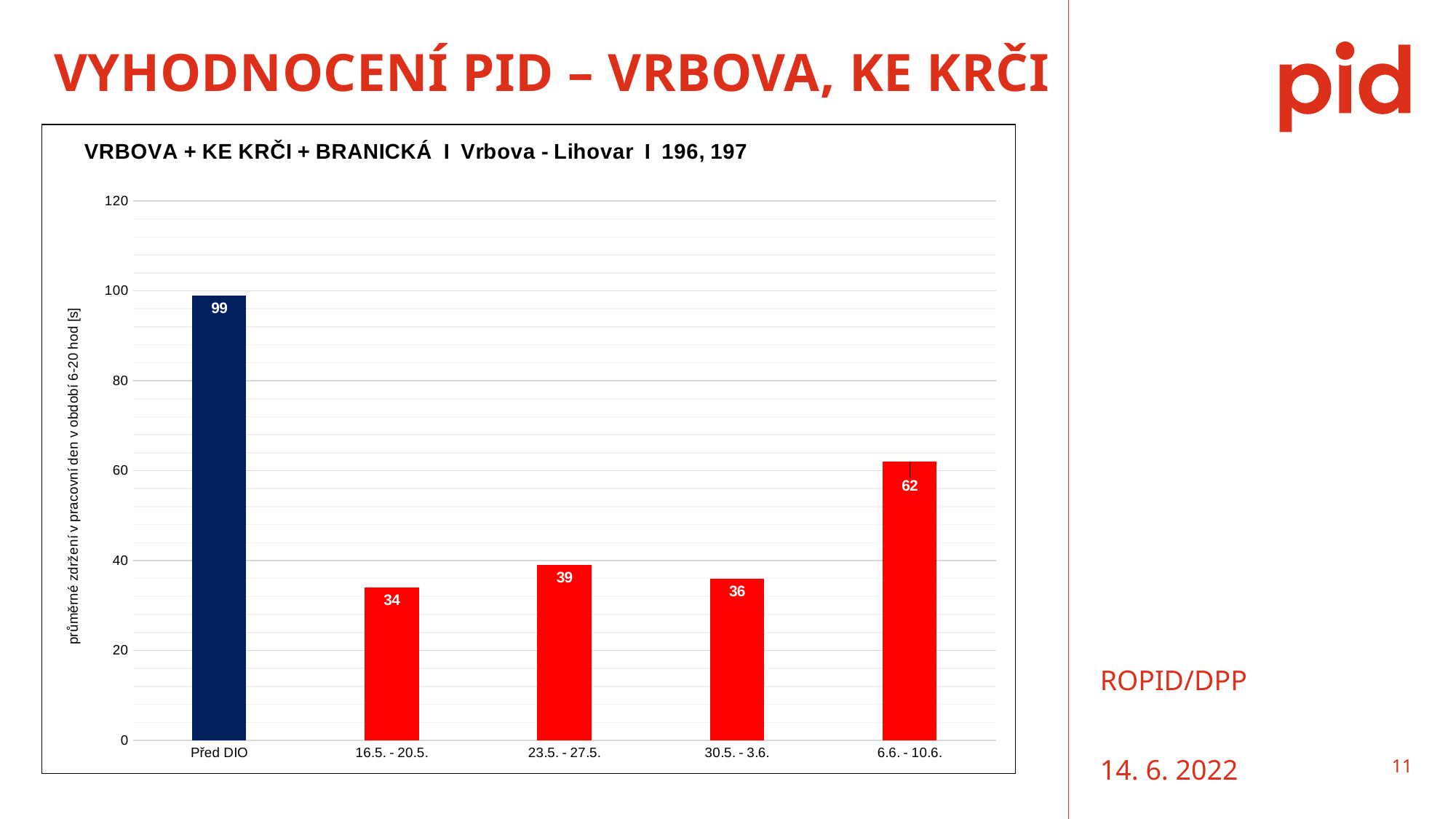
What is the title of the chart? VRBOVA + KE KRČI + BRANICKÁ I Vrbova - Lihovar I 196, 197 What is the difference between the values for Před DIO and 6.6. - 10.6.? 37 What is the difference between the values for 23.5. - 27.5. and 30.5. - 3.6.? 3 What kind of chart is shown on the slide? bar chart What is the value for 16.5. - 20.5.? 34 What is the value for 6.6. - 10.6.? 62 Is the value for 6.6. - 10.6. greater or less than 80? less What is the value for Před DIO? 99 Which category has the lowest value? 16.5. - 20.5. Which is larger, the value for 23.5. - 27.5. or the value for 30.5. - 3.6.? 23.5. - 27.5. How many categories are shown on the x axis? 5 Which category has the highest value? Před DIO